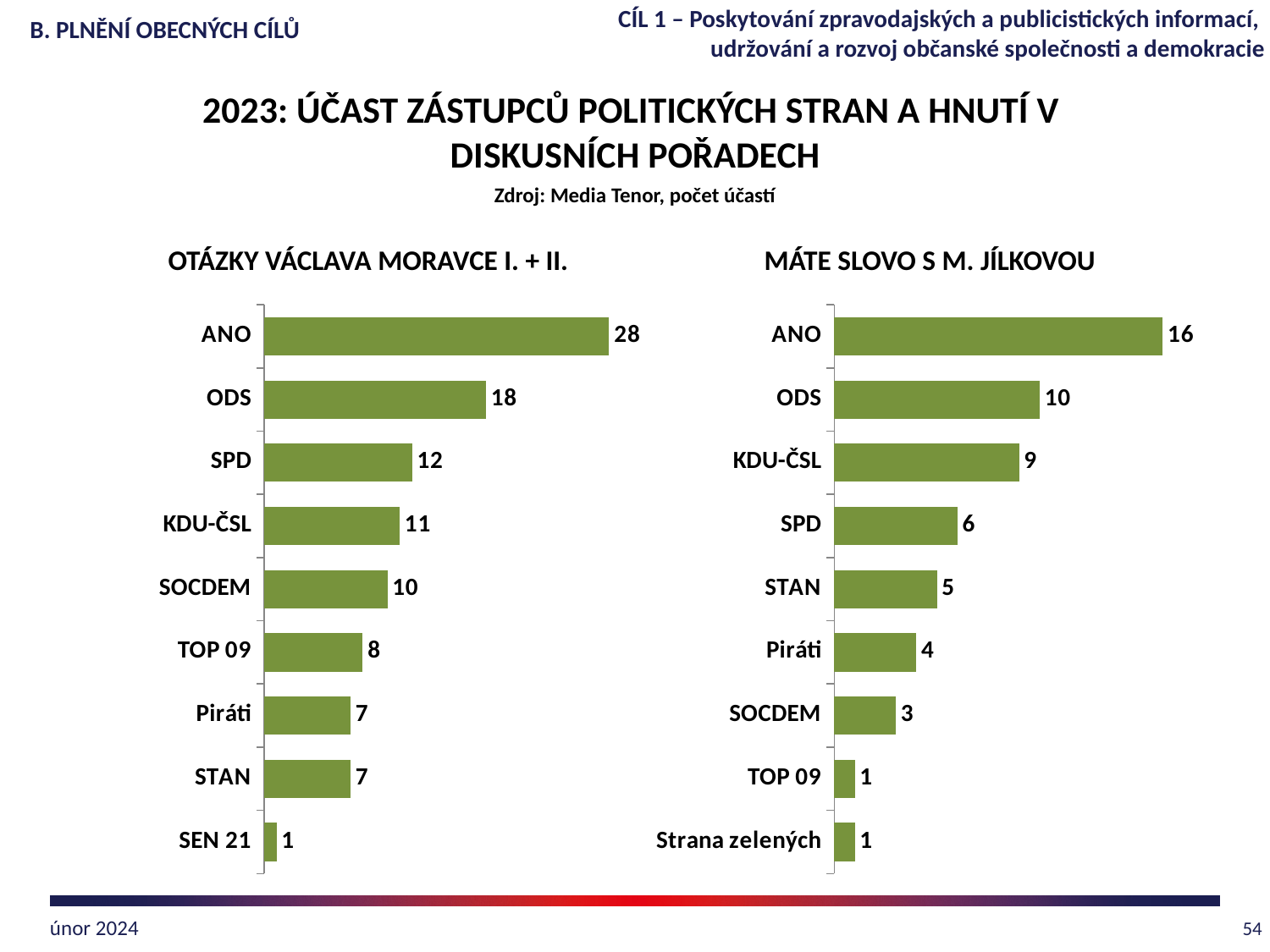
In the 'OTÁZKY VÁCLAVA MORAVCE I. + II.' chart, which category has the highest value? ANO In the 'OTÁZKY VÁCLAVA MORAVCE I. + II.' chart, what is the value for ODS? 18 In the 'OTÁZKY VÁCLAVA MORAVCE I. + II.' chart, what is the value for SEN 21? 1 In the 'OTÁZKY VÁCLAVA MORAVCE I. + II.' chart, what is the difference between the values for ANO and ODS? 10 What kind of chart is the 'MÁTE SLOVO S M. JÍLKOVOU' chart? Bar chart In the 'MÁTE SLOVO S M. JÍLKOVOU' chart, which is larger, the value for STAN or the value for SOCDEM? STAN In the 'OTÁZKY VÁCLAVA MORAVCE I. + II.' chart, which is larger, the value for SPD or the value for KDU-ČSL? SPD How many categories are shown in the 'OTÁZKY VÁCLAVA MORAVCE I. + II.' chart? 9 How many categories are shown in the 'MÁTE SLOVO S M. JÍLKOVOU' chart? 9 In the 'MÁTE SLOVO S M. JÍLKOVOU' chart, what is the value for KDU-ČSL? 9 In the 'MÁTE SLOVO S M. JÍLKOVOU' chart, what is the difference between the values for ANO and ODS? 6 In the 'MÁTE SLOVO S M. JÍLKOVOU' chart, which category has the lowest value? TOP 09 and Strana zelených